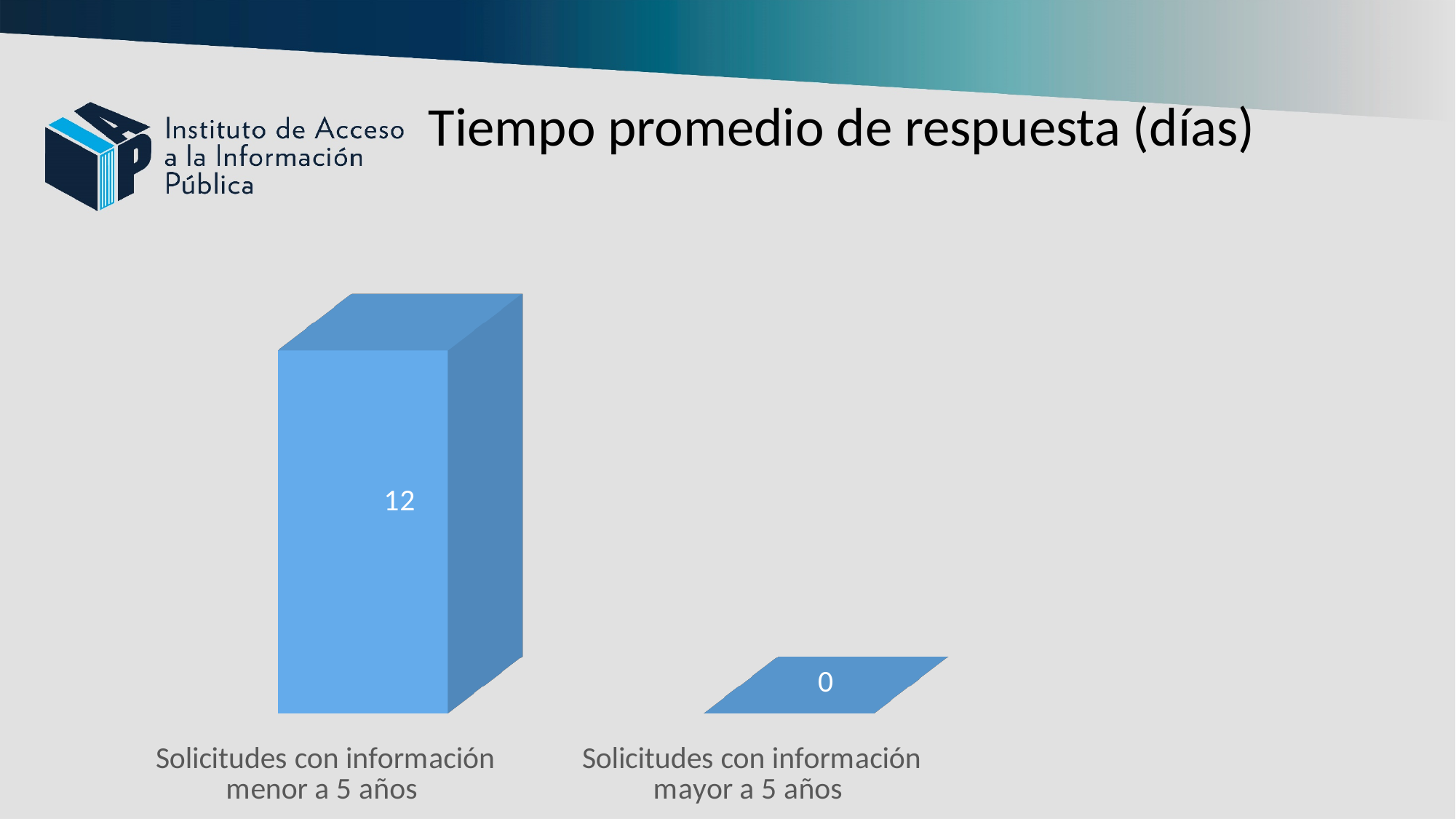
Which category has the highest value? Solicitudes con información menor a 5 años Which category has the lowest value? Solicitudes con información mayor a 5 años What is the total of the two values shown in the chart? 12 What kind of chart is shown on the slide? Bar chart Which is larger: the value for "Solicitudes con información menor a 5 años" or for "Solicitudes con información mayor a 5 años"? Solicitudes con información menor a 5 años What is the title of the chart? Tiempo promedio de respuesta (días) What is the value for "Solicitudes con información menor a 5 años"? 12 How many categories are shown in the chart? 2 What is the value for "Solicitudes con información mayor a 5 años"? 0 What is the difference between the values for "Solicitudes con información menor a 5 años" and "Solicitudes con información mayor a 5 años"? 12